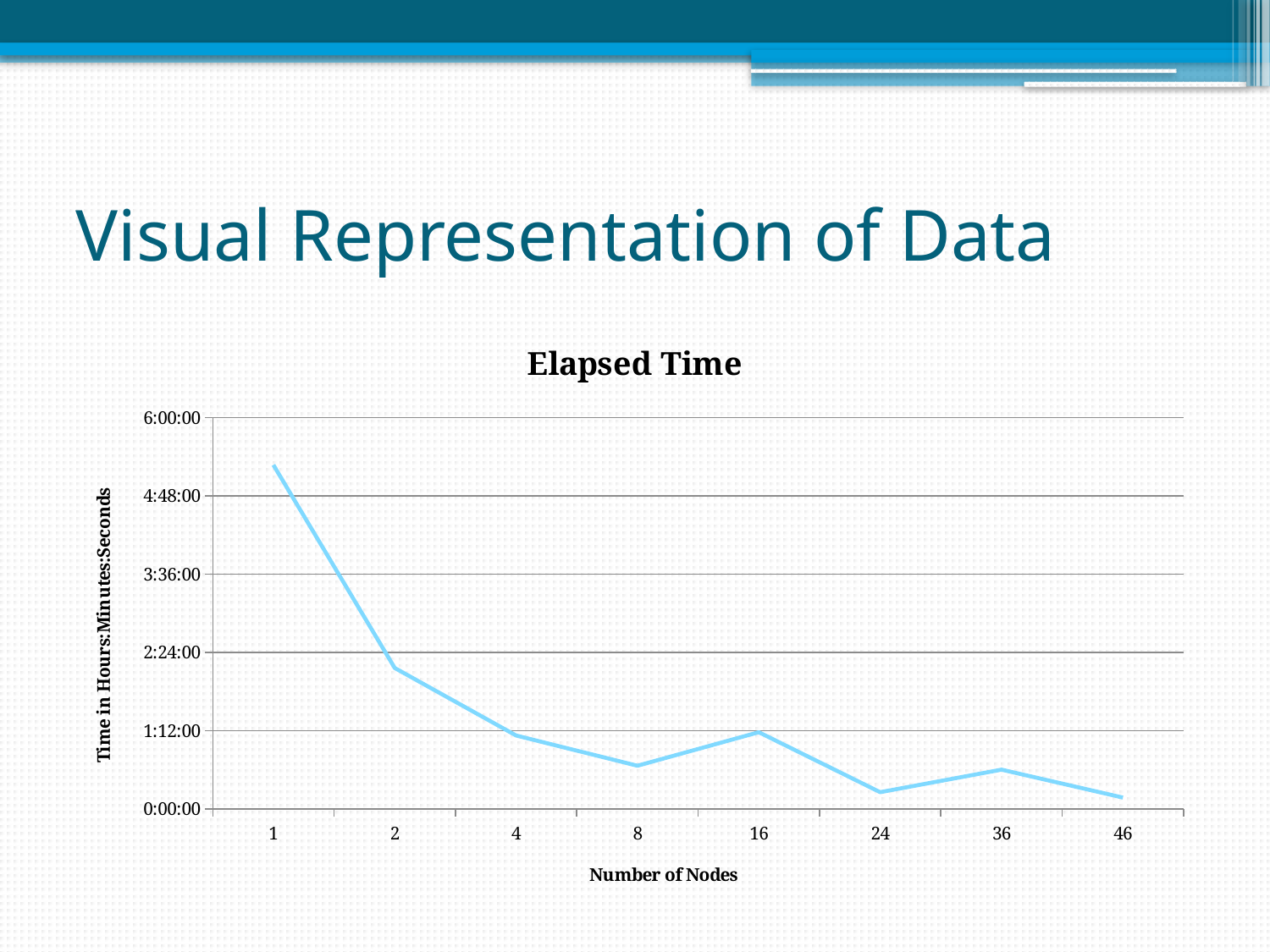
What is the label of the x axis? Number of Nodes Is the elapsed time for 24 nodes greater or less than 1:12:00? less Is the elapsed time for 2 nodes greater or less than 2:24:00? less What kind of chart is shown on the slide? line chart Which number of nodes has the highest elapsed time? 1 Which has the larger elapsed time, 24 nodes or 36 nodes? 36 nodes What is the title of the chart? Elapsed Time Is the elapsed time for 8 nodes greater or less than 1:12:00? less How many node counts are plotted along the x axis? 8 Which has the larger elapsed time, 8 nodes or 16 nodes? 16 nodes Overall, does the elapsed time rise or fall as the number of nodes increases? fall